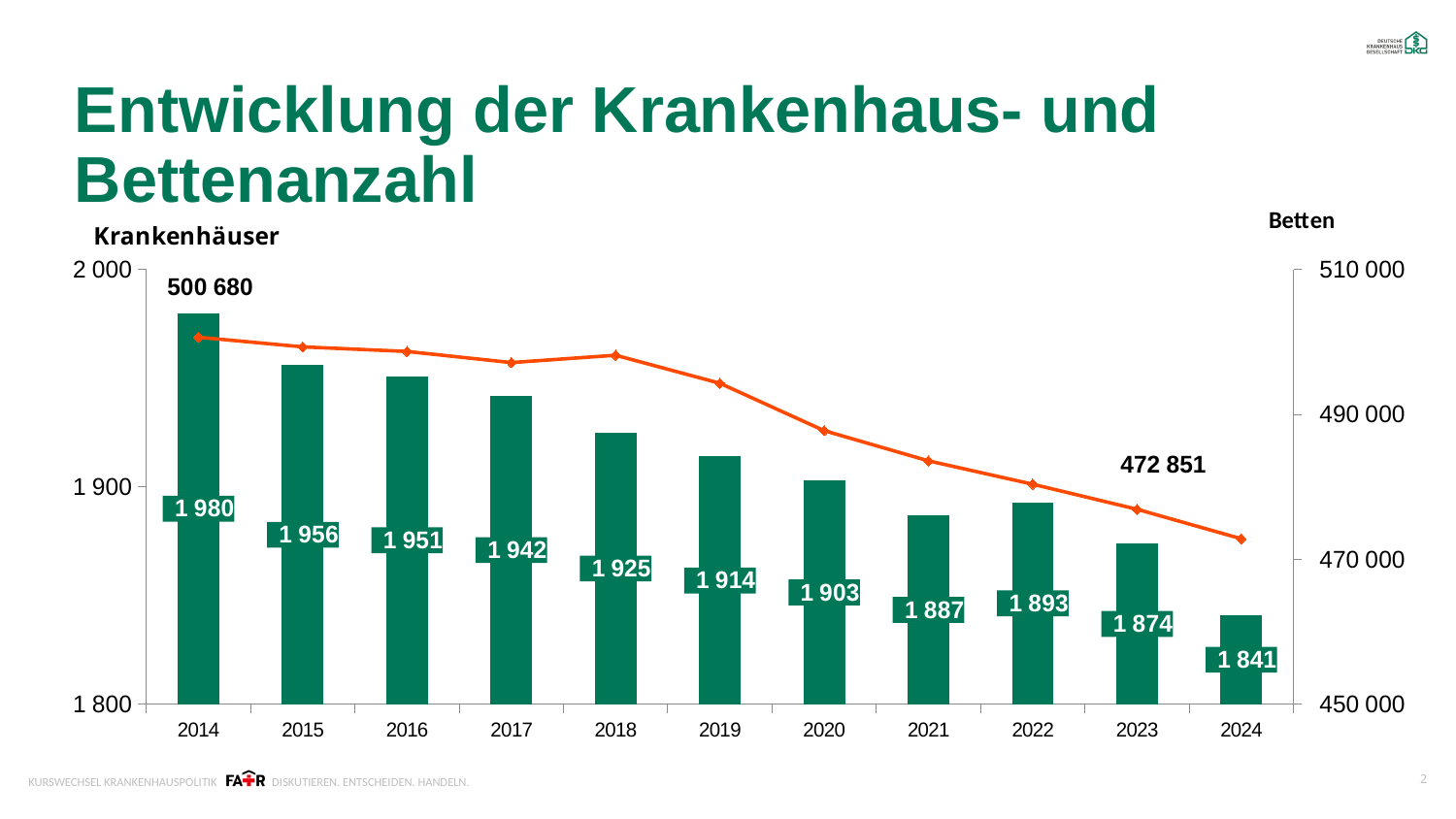
Which year has the highest number of Krankenhäuser? 2014 How many Krankenhäuser are shown for 2014? 1 980 What is the number of Krankenhäuser in 2024? 1 841 Which year has more Krankenhäuser, 2021 or 2022? 2022 Is the Betten value for 2019 greater or less than 490 000? greater What is the labelled number of Betten for 2014? 500 680 Is the Betten value for 2024 greater or less than 490 000? less By how much did the number of Krankenhäuser fall from 2014 to 2024? 139 What is the number of Krankenhäuser in 2020? 1 903 Which year has the lowest number of Krankenhäuser? 2024 What kind of chart is shown on the slide? Combined bar and line chart How many years are shown on the x axis? 11